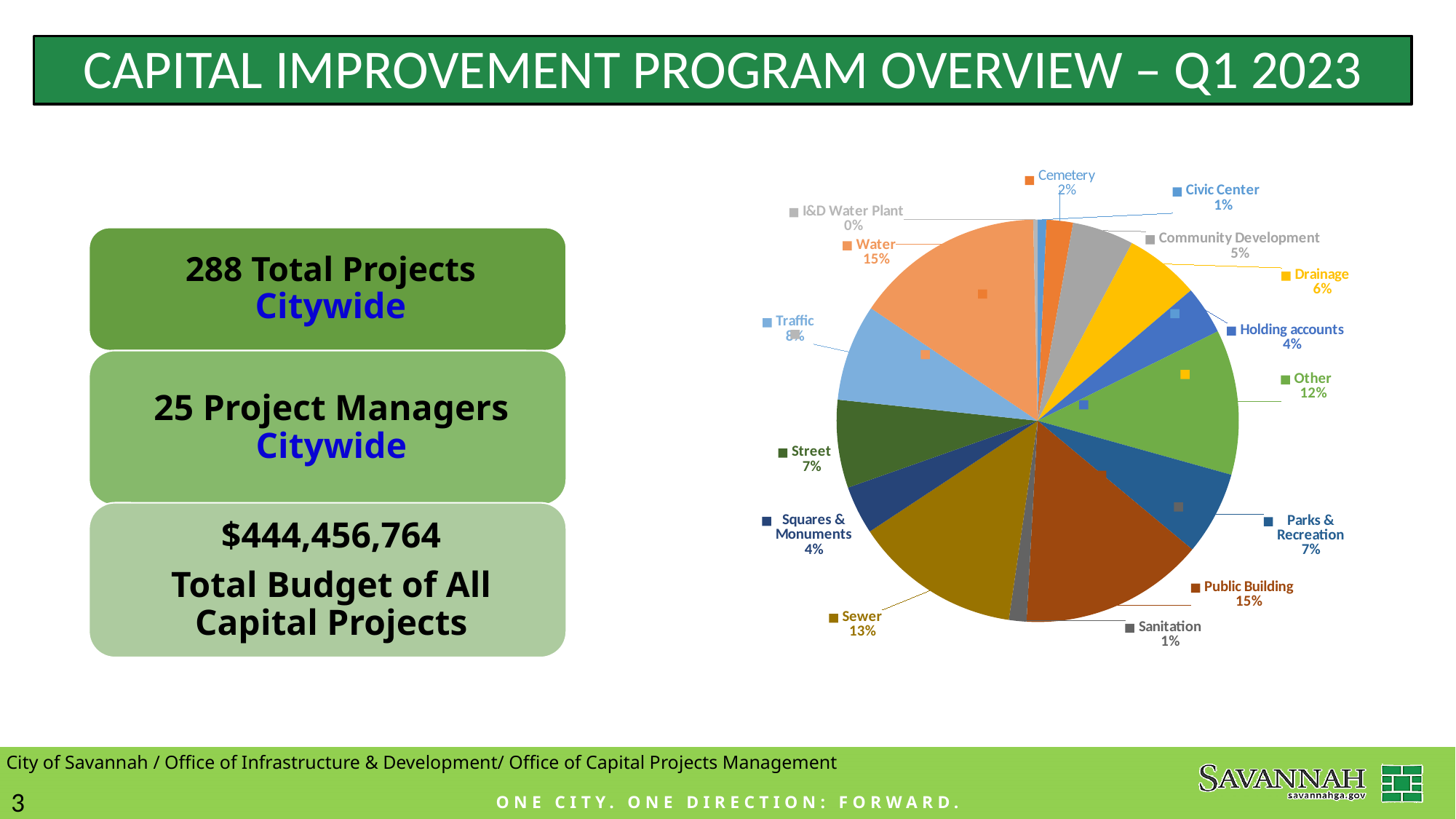
Which has a larger share, Traffic or Holding accounts? Traffic What kind of chart is shown on the slide? pie chart What share of the pie does Water represent? 15% What colour is the Sewer slice of the pie? dark gold What percentage is shown for Community Development? 5% What is the difference in percentage points between Public Building and Other? 3 How many categories are shown in the pie chart? 15 What is the combined share of Squares & Monuments and Street? 11% What share of the pie does Sewer represent? 13% What percentage is shown for Drainage? 6% What percentage is shown for Parks & Recreation? 7% Which category has the smallest share of the pie? I&D Water Plant